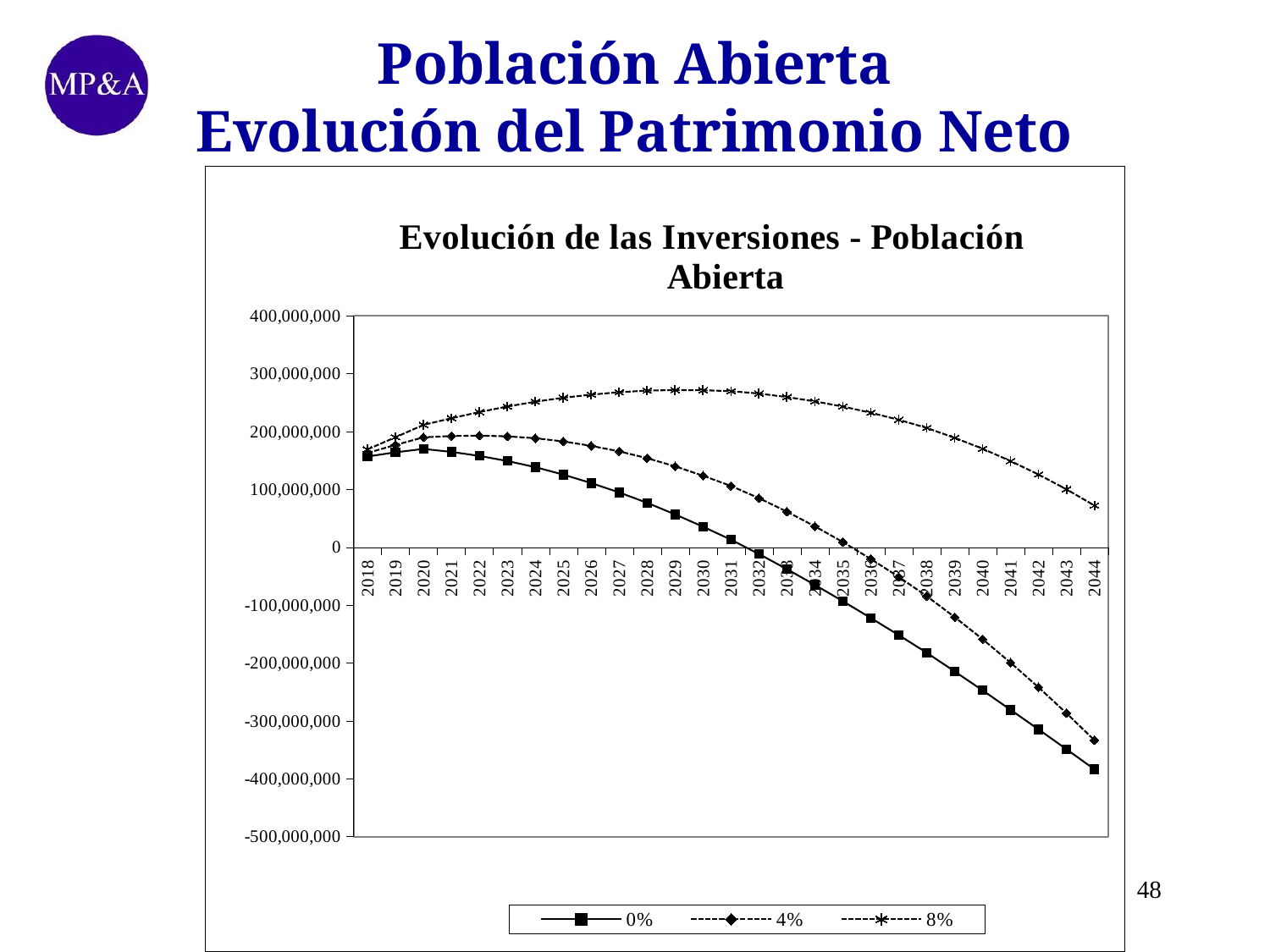
What are the three series named in the legend? 0%, 4%, 8% Does the 0% series rise or fall from 2020 to 2044? fall What kind of chart is shown on the slide? line chart Is the value of the 8% series in 2030 greater or less than 200,000,000? greater Is the value of the 0% series in 2044 greater or less than -300,000,000? less Which series has the lowest value in 2044? 0% How many years are plotted along the x axis? 27 Is the value of the 8% series in 2044 greater or less than 100,000,000? less In 2040, which series has the larger value, 4% or 0%? 4% How many series does the legend list? 3 What is the title of the chart? Evolución de las Inversiones - Población Abierta Which series has the highest value in 2044? 8%